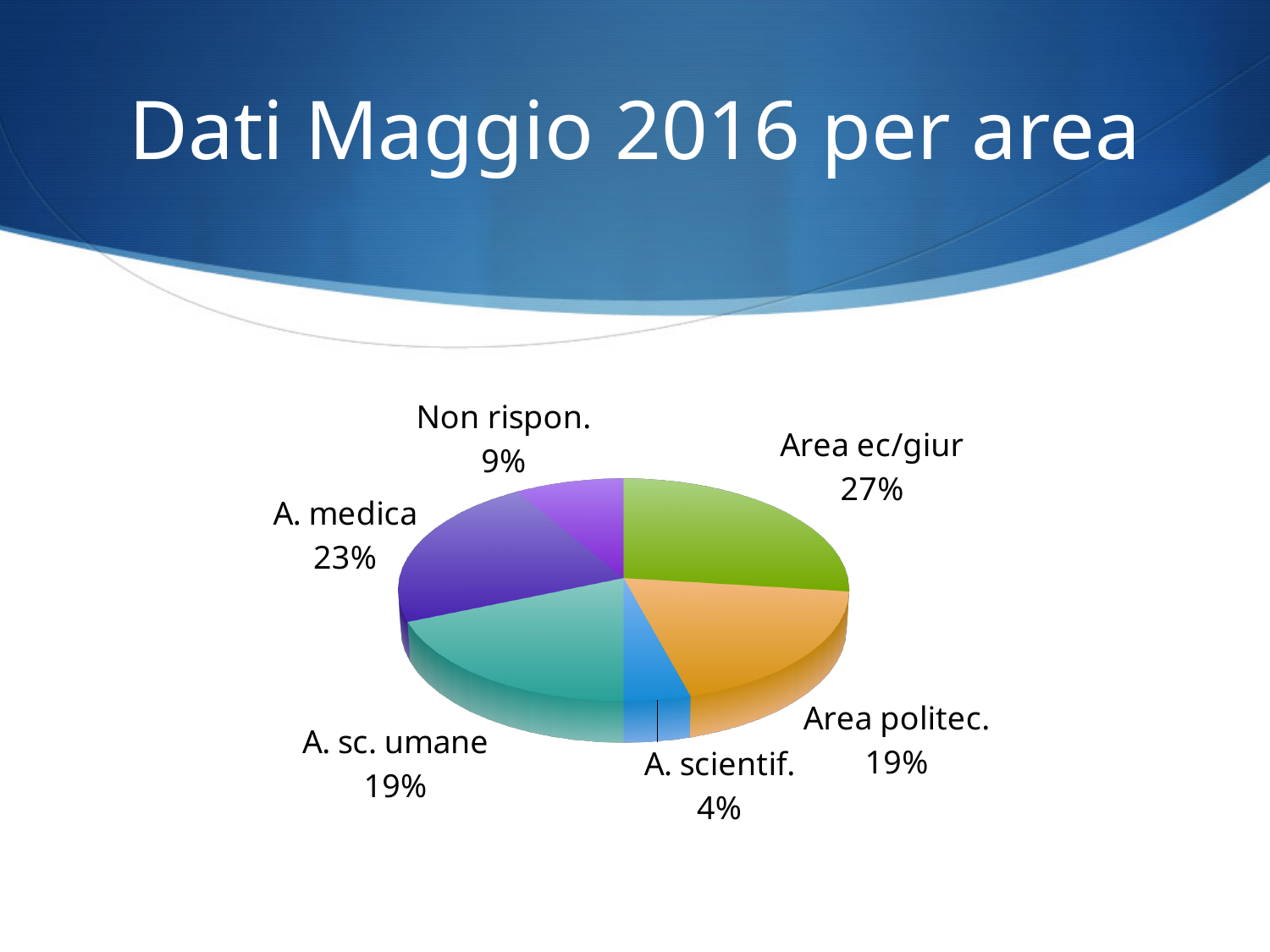
Which two categories share the same percentage of 19%? A. sc. umane and Area politec. What share of the pie does Area ec/giur represent? 27% How many categories are shown in the pie chart? 6 What is the title of the slide containing the chart? Dati Maggio 2016 per area What is the difference in percentage points between Area ec/giur and A. medica? 4 Which category has the largest slice of the pie? Area ec/giur What percentage is shown for Non rispon.? 9% Which category has the smallest slice of the pie? A. scientif. Which is larger, the share for A. medica or the share for Non rispon.? A. medica What percentage is shown for A. medica? 23% What kind of chart is shown on the slide? Pie chart What percentage is shown for A. scientif.? 4%